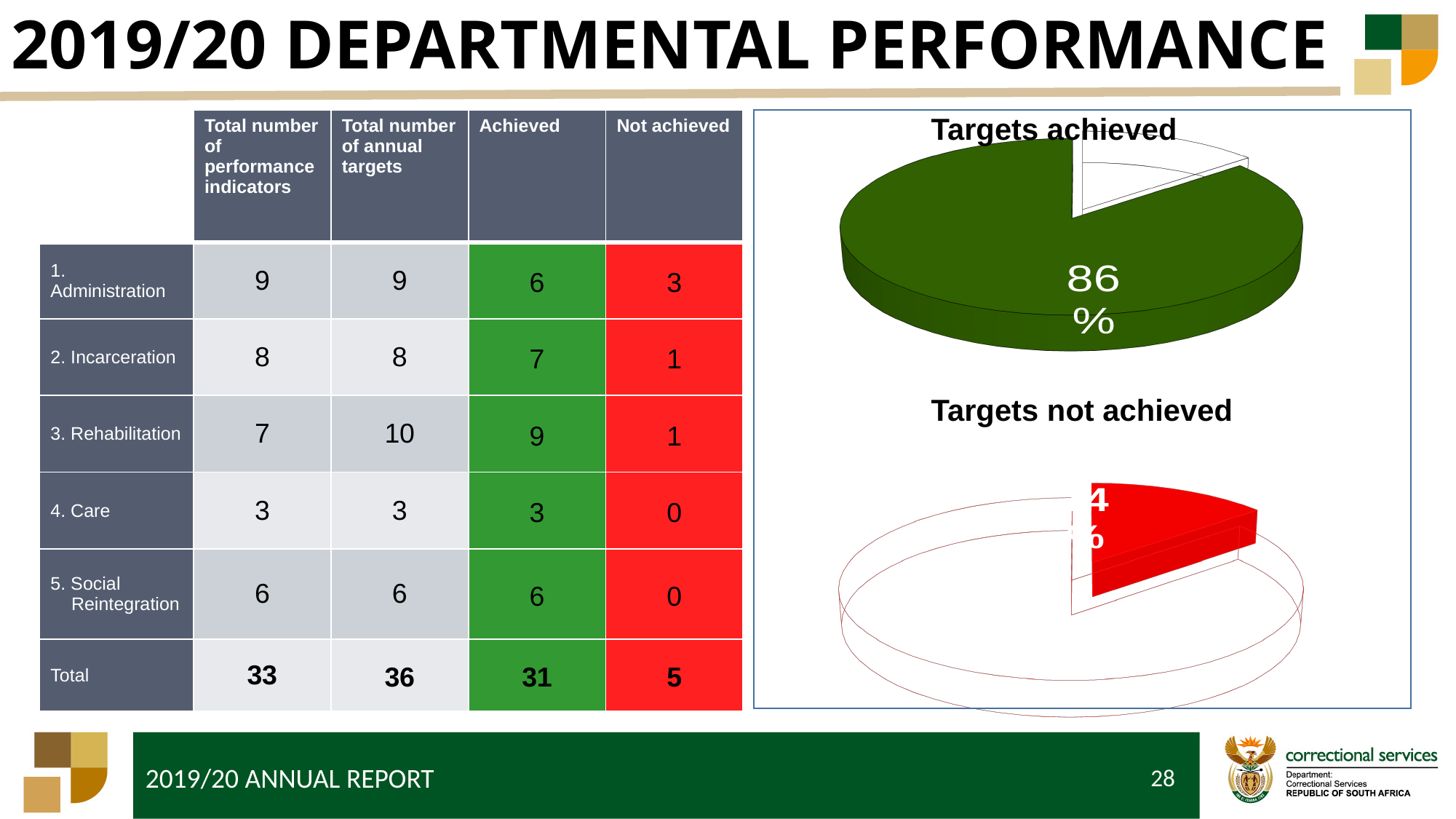
In the 'Targets achieved' pie chart, is the share for targets achieved greater or less than 50%? greater How many slices does the 'Targets achieved' pie chart have? 2 In the 'Targets achieved' pie chart, which slice is larger: targets achieved or targets not achieved? targets achieved In the 'Targets achieved' pie chart, what percentage is shown for the targets achieved slice? 86% In the 'Targets not achieved' pie chart, is the highlighted slice greater or less than 50% of the pie? less What kind of chart is used to show the targets achieved on the right of the slide? pie chart What colour is the slice in the 'Targets not achieved' pie chart? red What colour is the targets achieved slice in the 'Targets achieved' pie chart? green